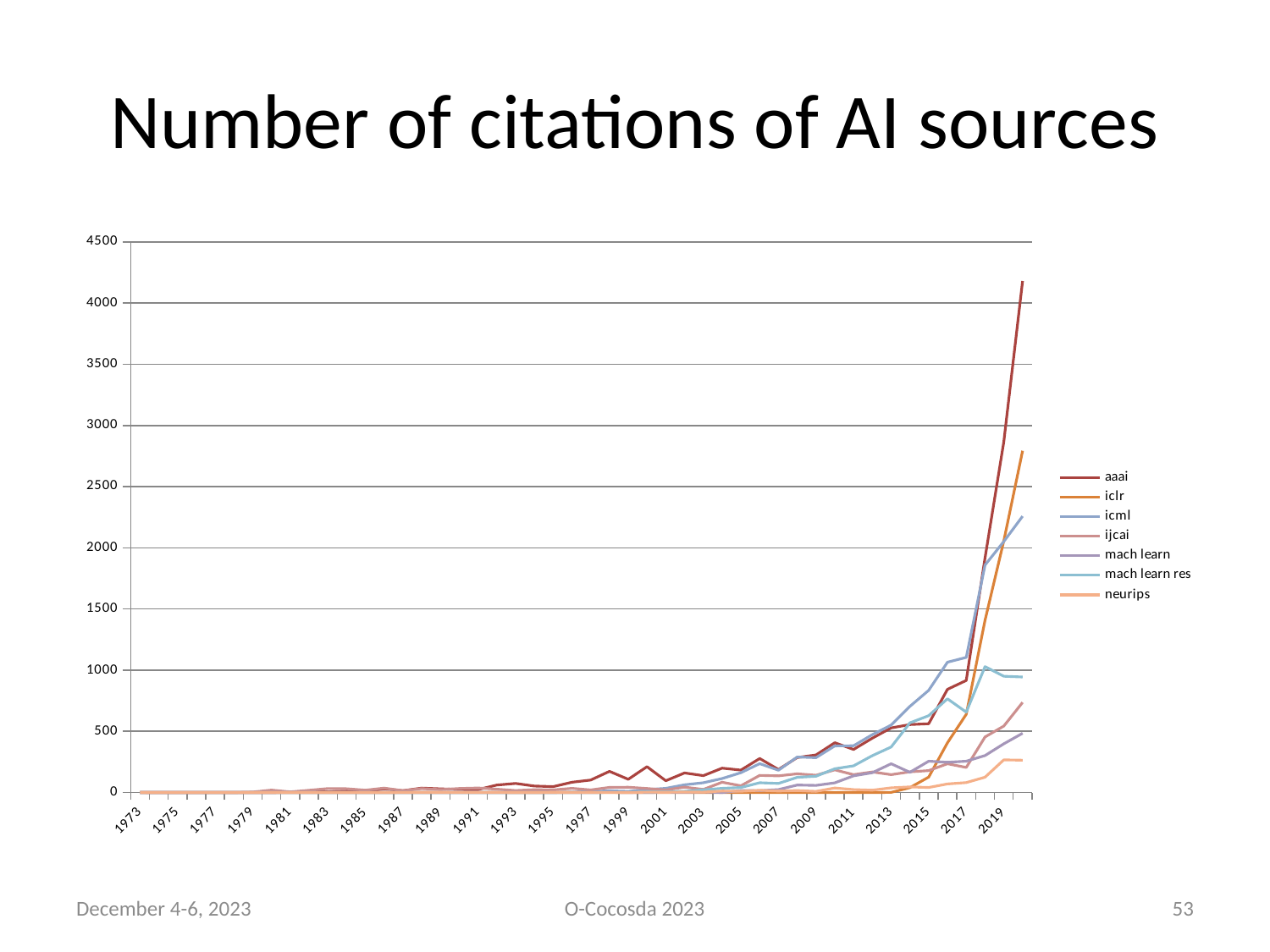
Which series has the lowest value at the right end of the chart? neurips Is the final value for neurips greater or less than 500? less Is the final value for ijcai greater or less than 500? greater Does the aaai series generally rise or fall from 1973 to the end of the chart? rise Is the final value for iclr greater or less than 2500? greater What is the title of the chart? Number of citations of AI sources At the right end of the chart, which is higher, iclr or icml? iclr Which series reaches the highest value at the right end of the chart? aaai What kind of chart is shown on the slide? line chart How many series does the legend list? 7